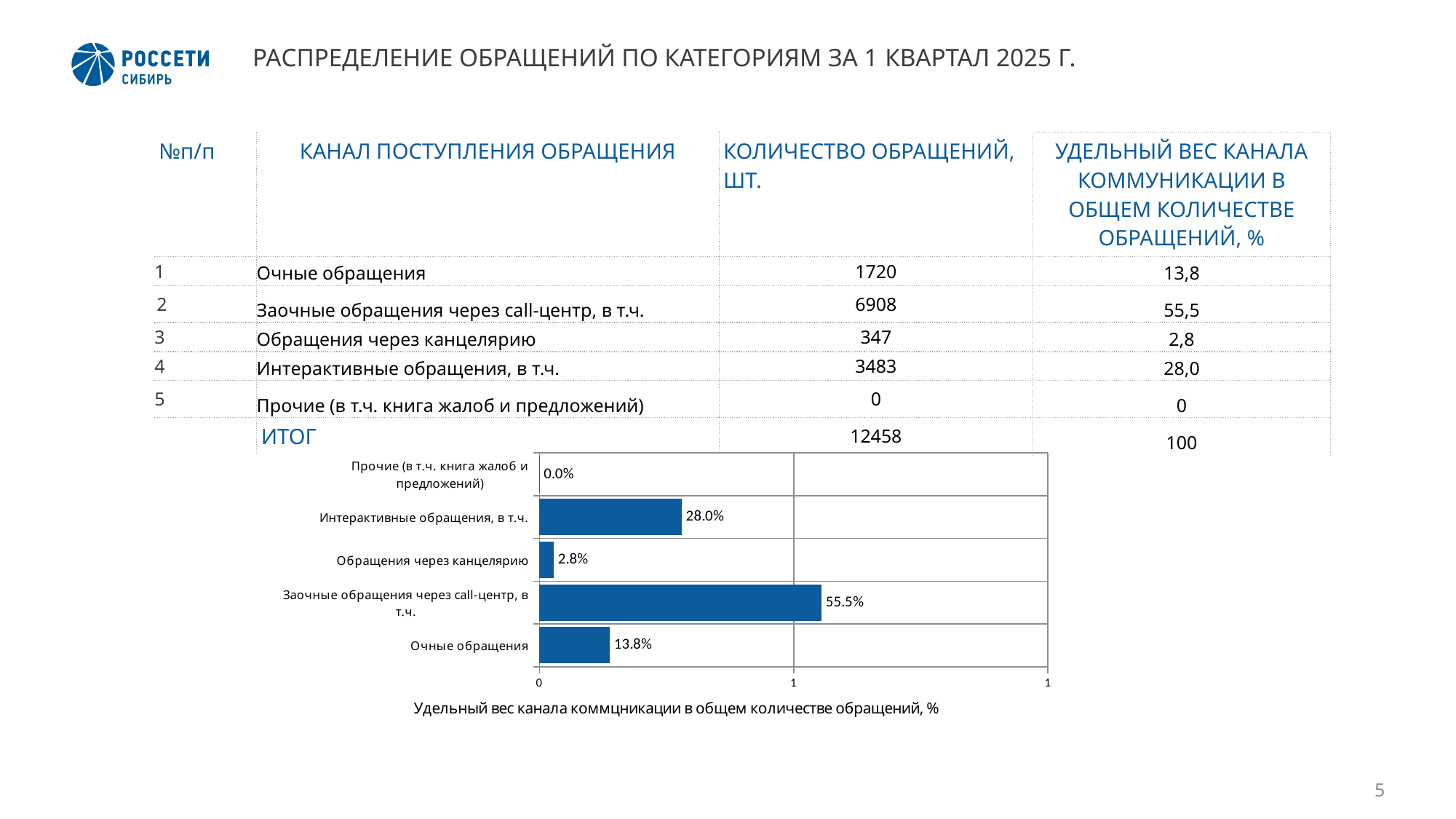
How many categories are plotted in the bar chart? 5 What is the value shown for "Обращения через канцелярию" in the bar chart? 2.8% Which category has the lowest value in the bar chart? Прочие (в т.ч. книга жалоб и предложений) What is the value shown for "Прочие (в т.ч. книга жалоб и предложений)" in the bar chart? 0.0% What text is shown below the bar chart's horizontal axis? Удельный вес канала коммцникации в общем количестве обращений, % What is the value shown for "Интерактивные обращения, в т.ч." in the bar chart? 28.0% What type of chart is shown on the slide? bar chart What is the difference between the values for "Заочные обращения через call-центр, в т.ч." and "Интерактивные обращения, в т.ч." in the bar chart? 27.5% What is the value shown for "Очные обращения" in the bar chart? 13.8% Which category has the highest value in the bar chart? Заочные обращения через call-центр, в т.ч. Which is larger in the bar chart: the value for "Очные обращения" or the value for "Обращения через канцелярию"? Очные обращения What is the value shown for "Заочные обращения через call-центр, в т.ч." in the bar chart? 55.5%